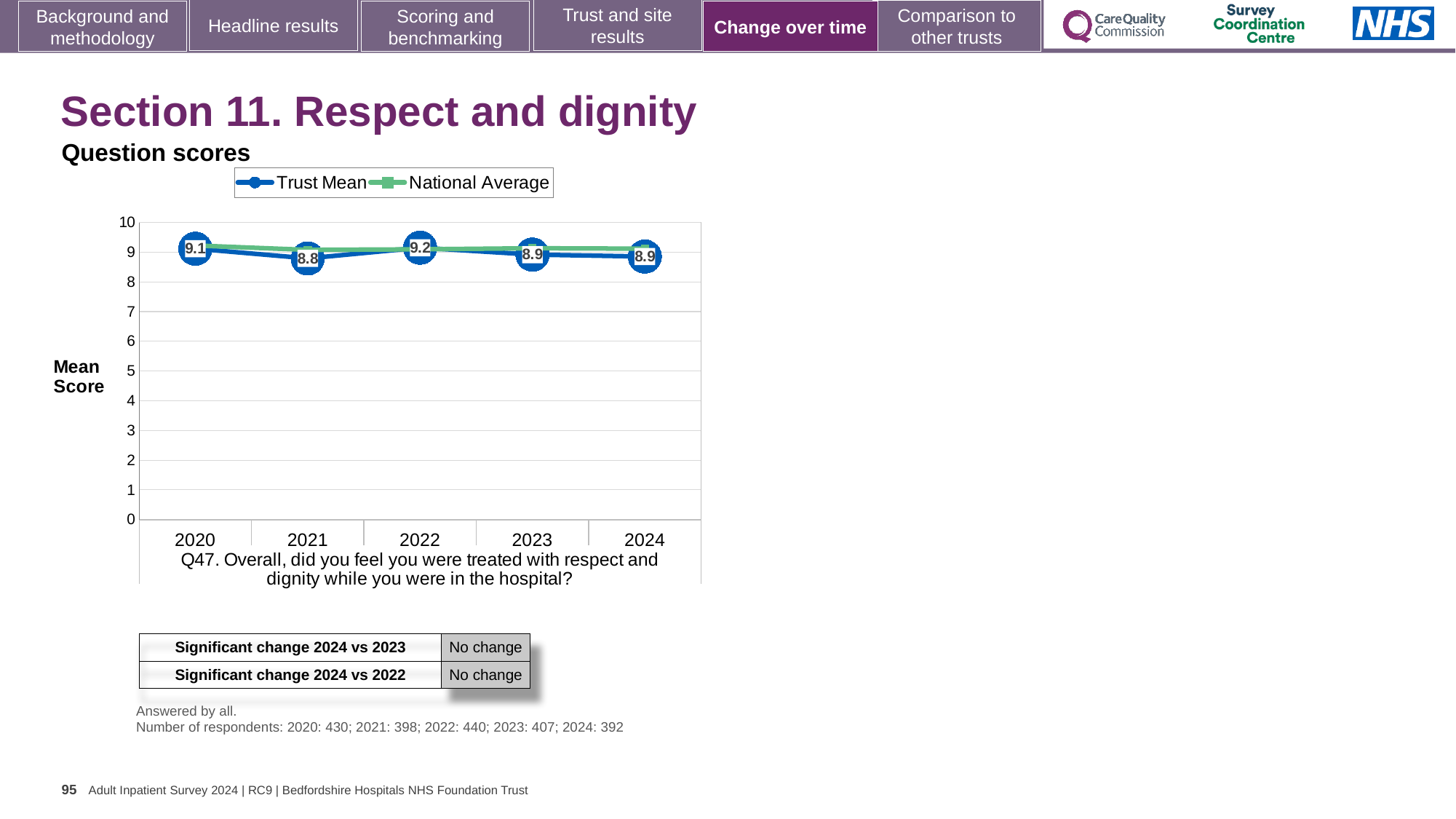
Does the Trust Mean score rise or fall from 2020 to 2021? Fall What is the Trust Mean score for 2021? 8.8 In which year is the Trust Mean score lowest? 2021 What kind of chart is shown? Line chart What is the Trust Mean score for 2024? 8.9 How many series does the legend list? 2 How many years are plotted on the x axis? 5 What is the difference between the Trust Mean scores for 2022 and 2021? 0.4 Is the National Average value for 2021 greater or less than 8? greater What is the Trust Mean score for 2022? 9.2 Which is larger, the Trust Mean score for 2020 or for 2021? 2020 In which year is the Trust Mean score highest? 2022